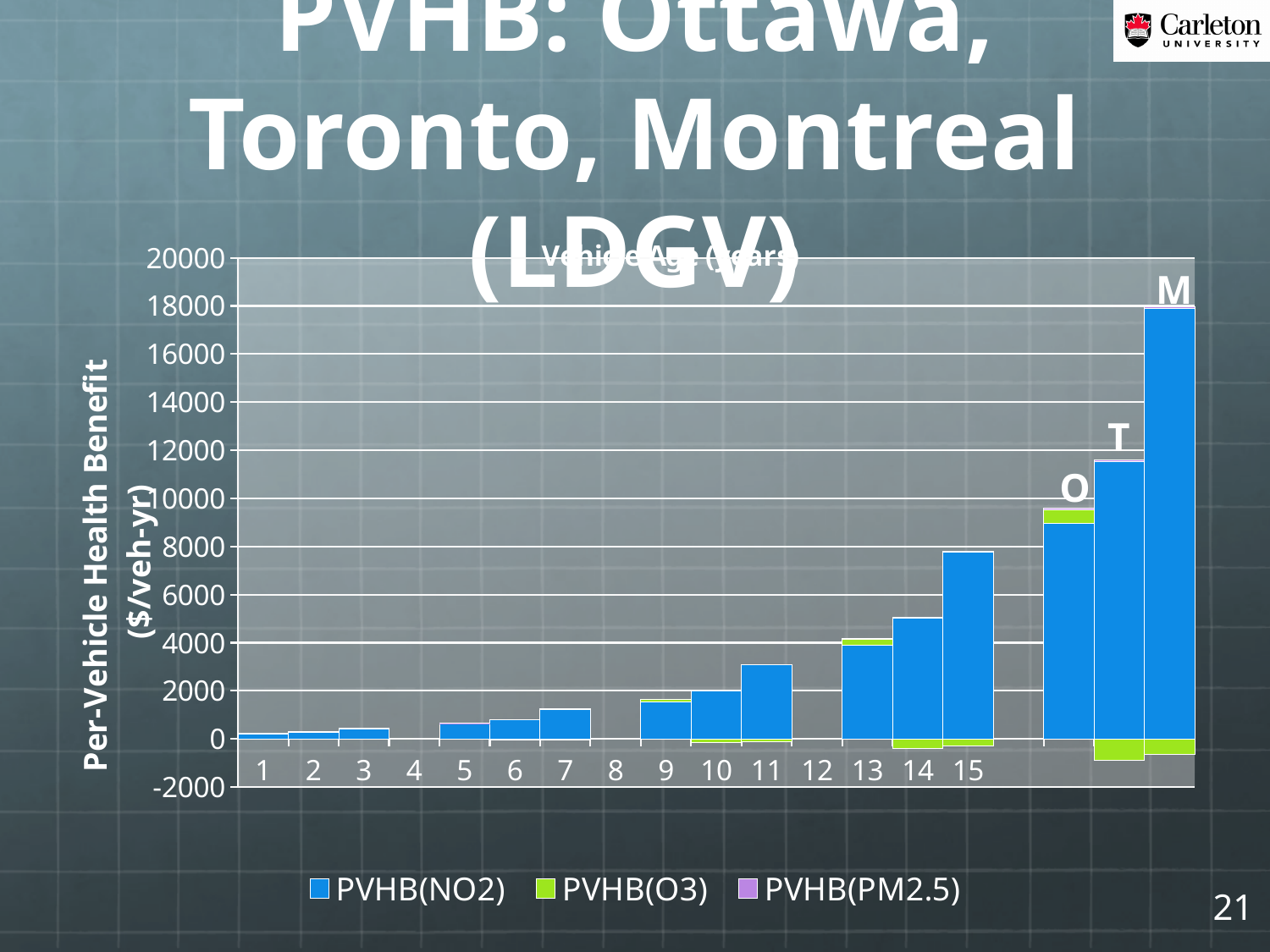
What is the y-axis title of the chart? Per-Vehicle Health Benefit ($/veh-yr) Is the PVHB(NO2) value for the bar labelled M greater or less than 16000? greater Which bar has the highest PVHB(NO2) value? M Is the PVHB(NO2) value for vehicle age 1 greater or less than 2000? less Is the PVHB(NO2) value for vehicle age 15 greater or less than 6000? greater How many series does the legend list? 3 Which series is shown in green in the legend? PVHB(O3) Which has the larger PVHB(NO2) value, the bar labelled T or the bar labelled O? T Do the PVHB(NO2) values generally rise or fall as vehicle age increases from 1 to 15? rise What kind of chart is shown on the slide? bar chart